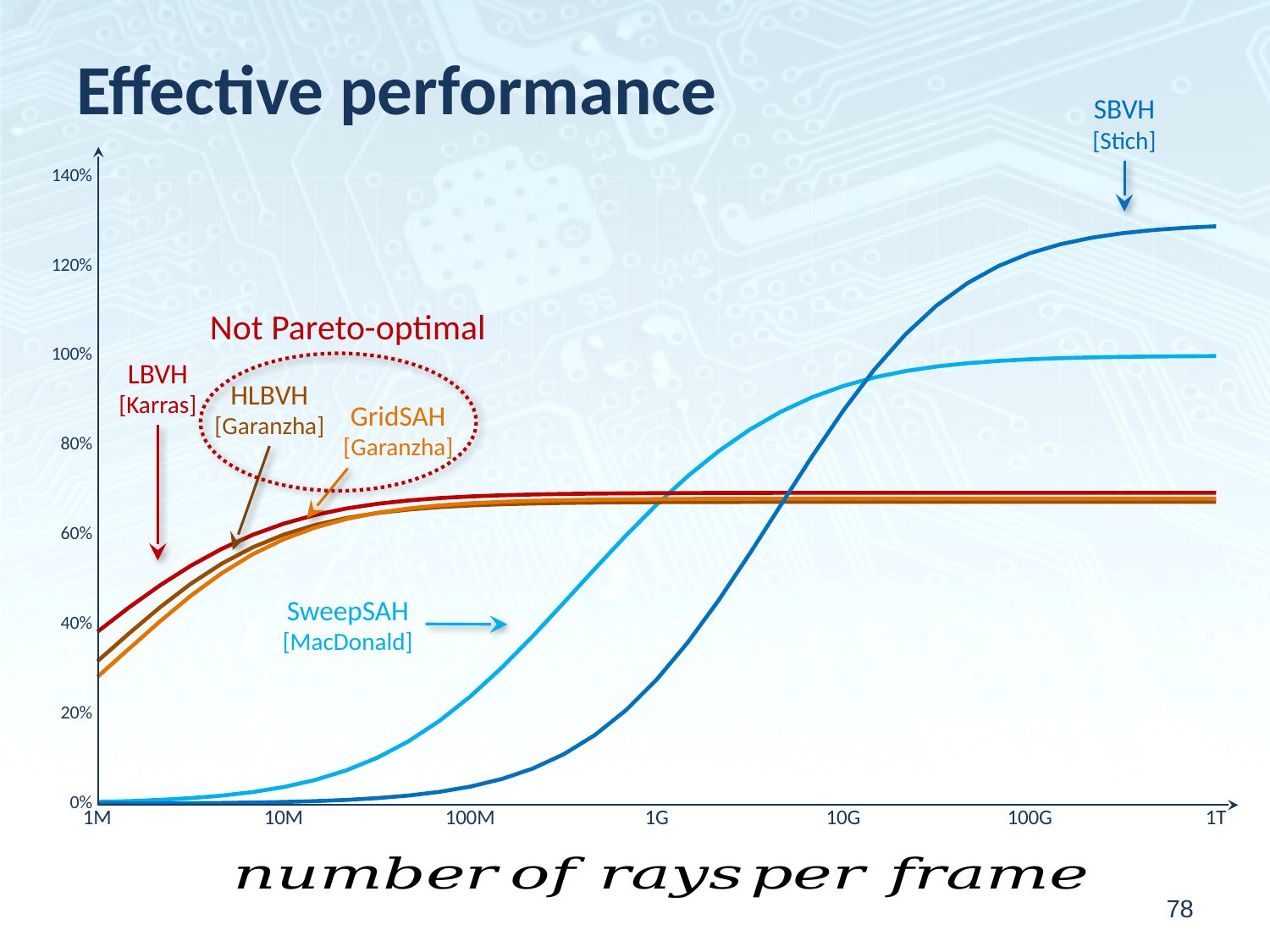
What is the title of the chart slide? Effective performance What kind of chart is shown on the slide? line chart Is the value for SBVH [Stich] at 100M rays per frame greater or less than 20%? less How many curves (methods) are plotted on the chart? 5 Which method has the highest effective performance at 1T rays per frame? SBVH [Stich] Does the SBVH [Stich] curve rise or fall as the number of rays per frame increases? rise Is the value for LBVH [Karras] at 1T rays per frame greater or less than 80%? less Is the value for SBVH [Stich] at 1T rays per frame greater or less than 120%? greater At 1M rays per frame, which is larger: LBVH [Karras] or SBVH [Stich]? LBVH [Karras] What is the label of the x axis? number of rays per frame How many tick labels are shown on the x axis? 7